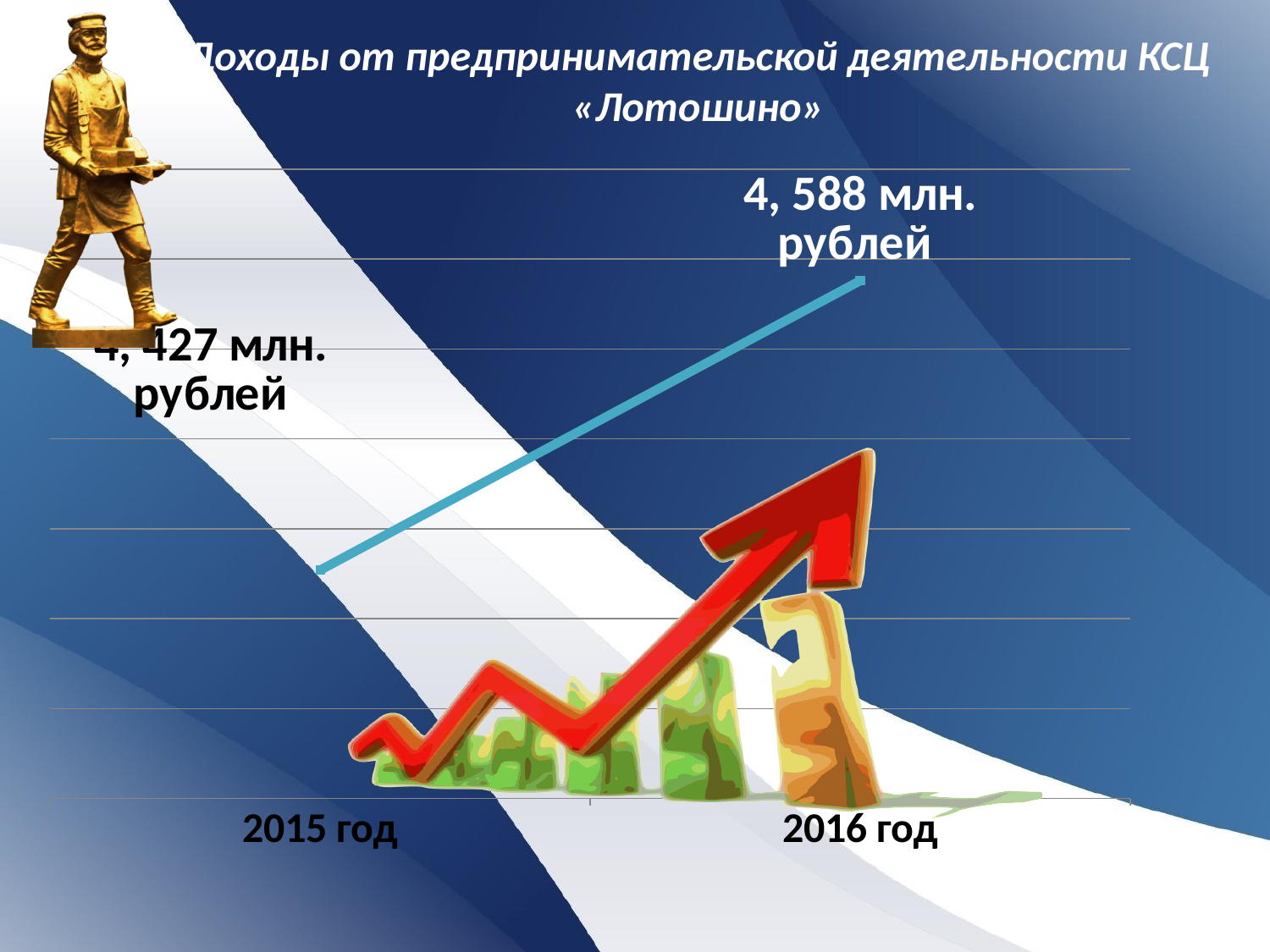
What is the value shown for 2016 год? 4, 588 млн. рублей Which year has the highest value on the chart? 2016 год By how much did the value increase from 2015 год to 2016 год? 0,161 млн. рублей What colour is the plotted line on the chart? Light blue What kind of chart is shown on the slide? Line chart How many data points are plotted on the chart? 2 Which year has the lowest value on the chart? 2015 год Do the values rise or fall from 2015 год to 2016 год? Rise Which year has the higher value, 2015 год or 2016 год? 2016 год What is the title of the chart? Доходы от предпринимательской деятельности КСЦ «Лотошино» What is the value shown for 2015 год? 4, 427 млн. рублей